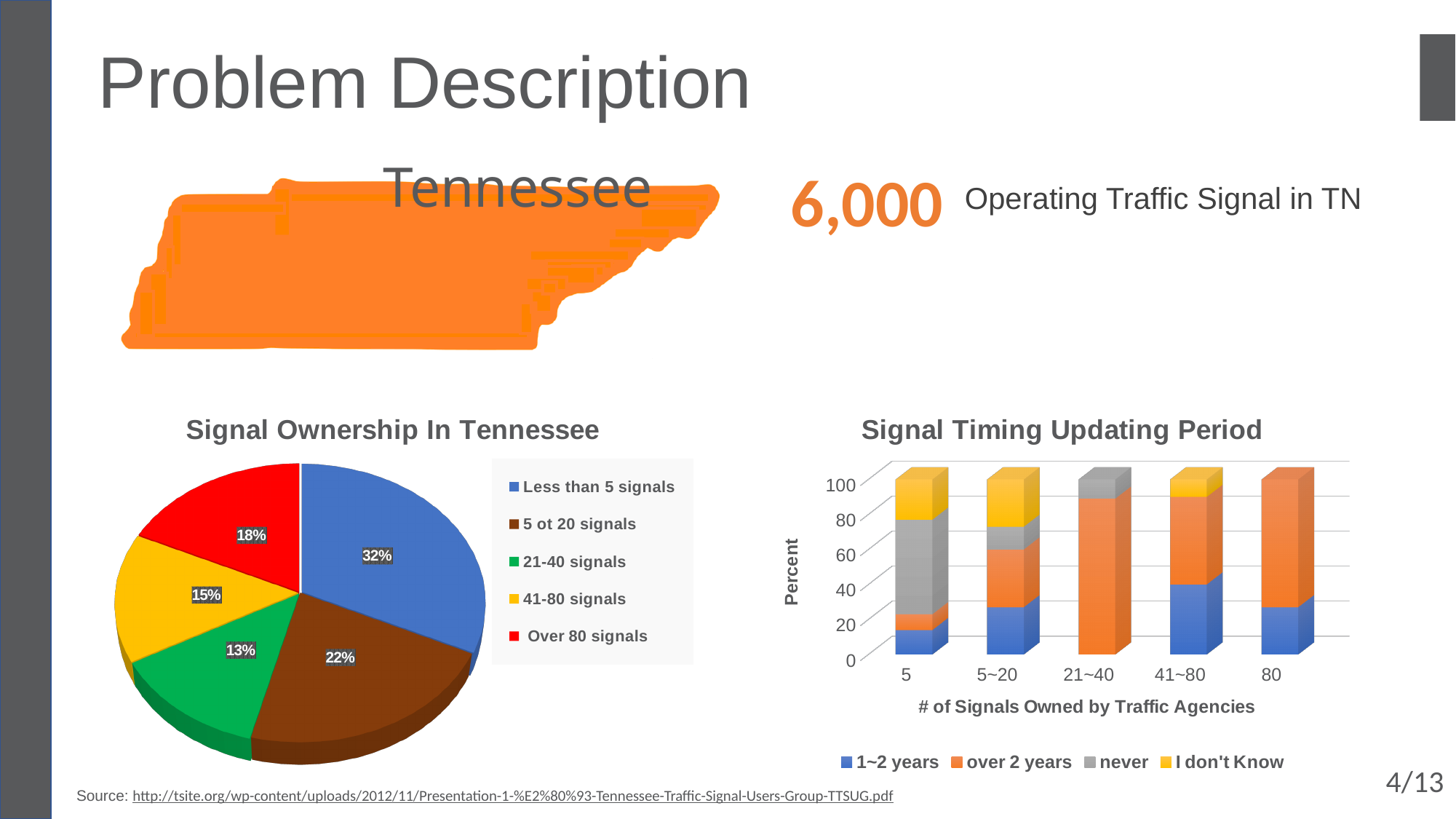
In the Signal Ownership In Tennessee chart, which category has the smallest share? 21-40 signals In the Signal Ownership In Tennessee chart, what share of the pie is Over 80 signals? 18% In the Signal Ownership In Tennessee chart, which is larger: the share for 41-80 signals or the share for Over 80 signals? Over 80 signals How many categories are shown on the x axis of the Signal Timing Updating Period chart? 5 In the Signal Ownership In Tennessee chart, what share of the pie is Less than 5 signals? 32% In the Signal Ownership In Tennessee chart, what is the difference between the shares for 5 ot 20 signals and 41-80 signals? 7% How many series does the legend of the Signal Timing Updating Period chart list? 4 In the Signal Timing Updating Period chart, is the 1~2 years value for the 80 category greater or less than 40? less What is the y-axis title of the Signal Timing Updating Period chart? Percent In the Signal Ownership In Tennessee chart, which category has the largest share? Less than 5 signals What kind of chart is Signal Ownership In Tennessee? Pie chart In the Signal Ownership In Tennessee chart, what share of the pie is 21-40 signals? 13%